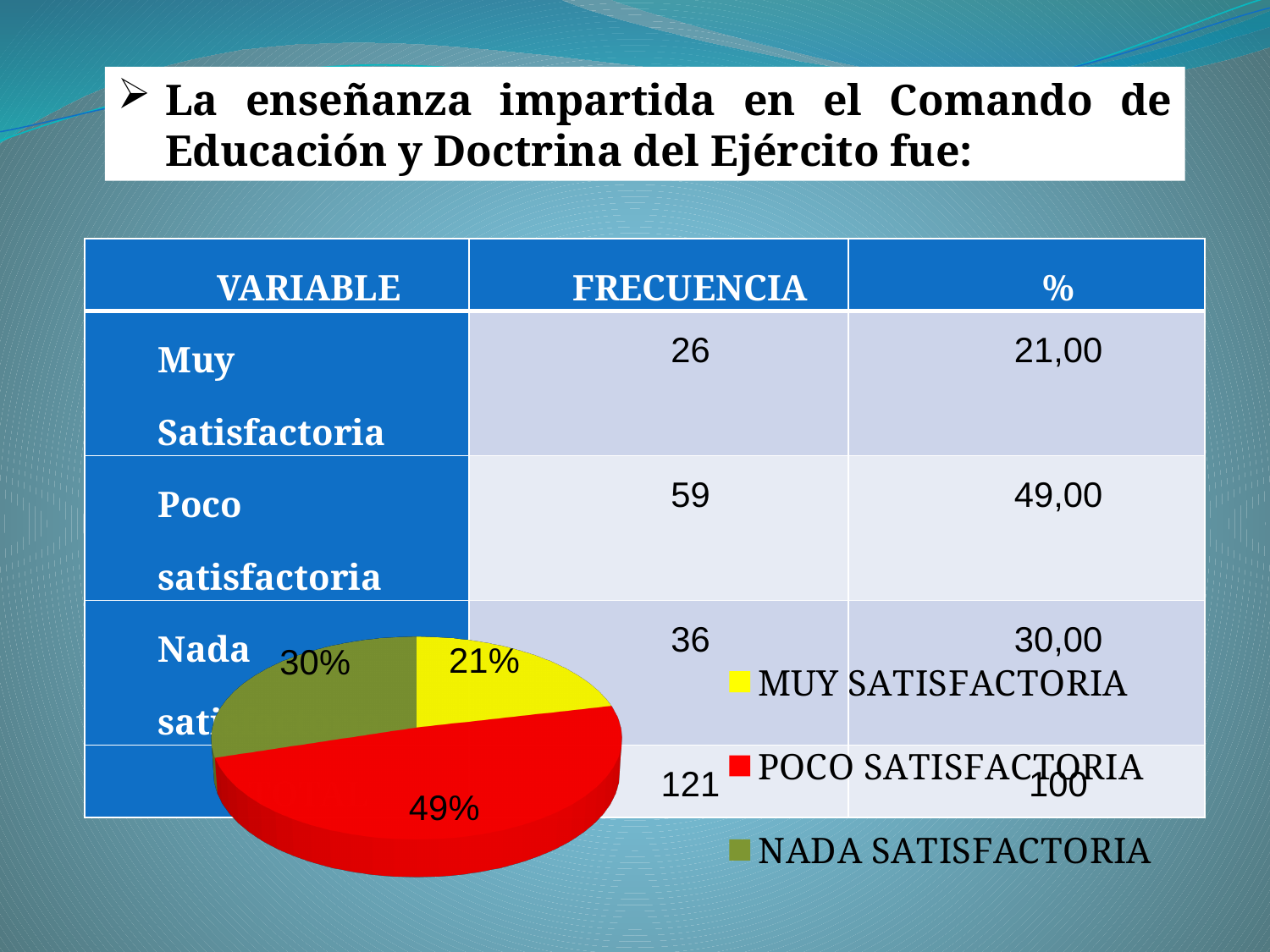
What share of the pie chart does NADA SATISFACTORIA represent? 30% Which category has the largest slice in the pie chart? POCO SATISFACTORIA What share of the pie chart does MUY SATISFACTORIA represent? 21% What share of the pie chart does POCO SATISFACTORIA represent? 49% Which category has the smallest slice in the pie chart? MUY SATISFACTORIA How many entries does the pie chart legend list? 3 Which slice is larger in the pie chart, NADA SATISFACTORIA or MUY SATISFACTORIA? NADA SATISFACTORIA What colour is the POCO SATISFACTORIA slice in the pie chart? Red What colour is the MUY SATISFACTORIA slice in the pie chart? Yellow What is the difference in percentage points between the POCO SATISFACTORIA slice and the MUY SATISFACTORIA slice? 28 How many slices does the pie chart have? 3 What kind of chart is shown on the slide? Pie chart